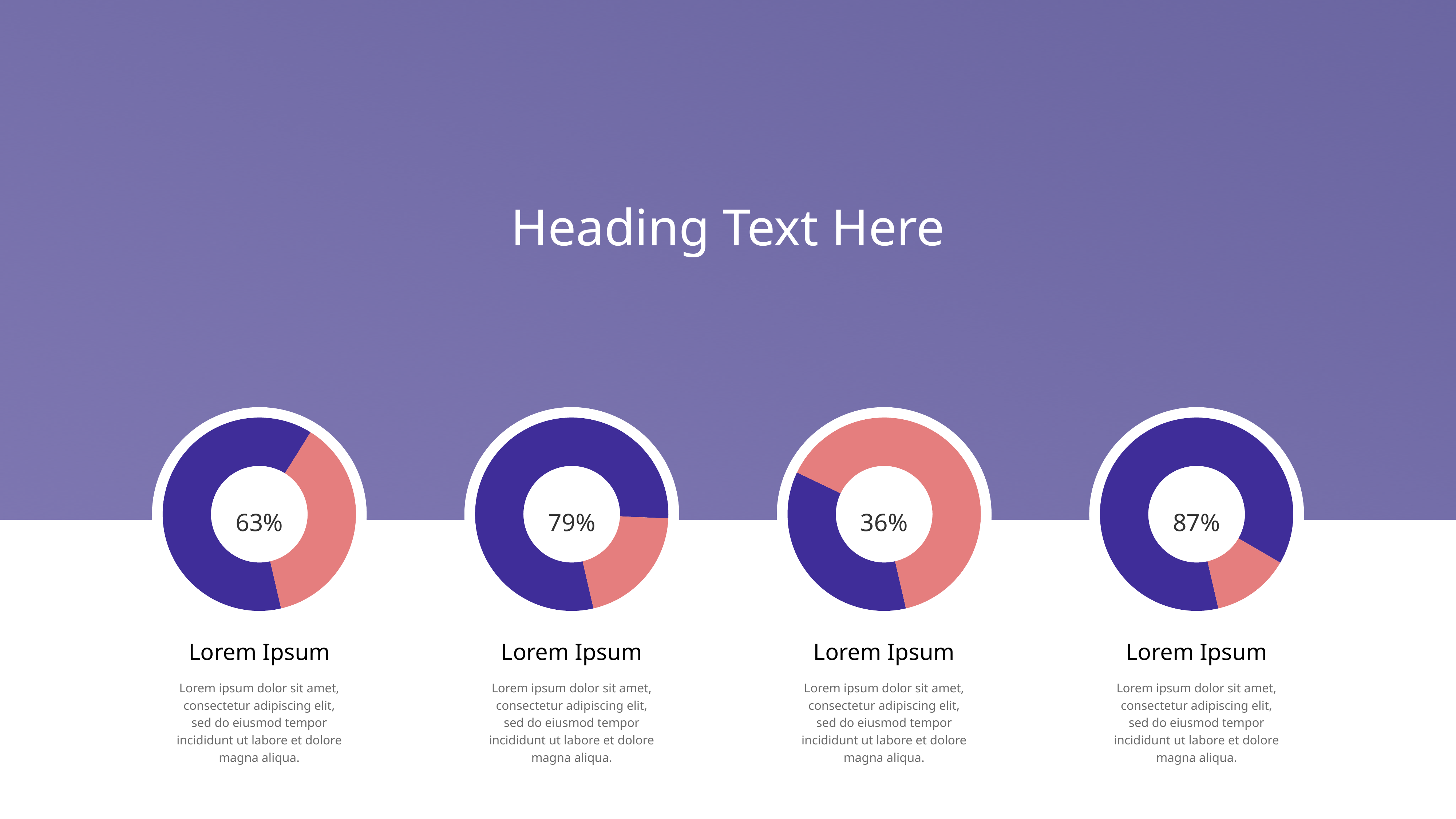
Which of the four donut charts shows the highest percentage? The rightmost chart (87%) Which of the four donut charts shows the lowest percentage? The third chart from the left (36%) Which is larger: the percentage in the leftmost donut chart or the percentage in the second donut chart from the left? The second chart (79%) What percentage is shown in the centre of the second donut chart from the left? 79% What kind of chart is used to display the percentages on this slide? Donut chart What is the difference between the percentage in the rightmost donut chart and the percentage in the leftmost donut chart? 24% What percentage is shown in the centre of the third donut chart from the left? 36% How many donut charts are shown on the slide? 4 What percentage is shown in the centre of the leftmost donut chart? 63% What is the difference between the percentage in the second donut chart and the percentage in the third donut chart? 43% What percentage is shown in the centre of the rightmost donut chart? 87% In the third donut chart from the left, which colour fills the larger portion of the ring? Pink